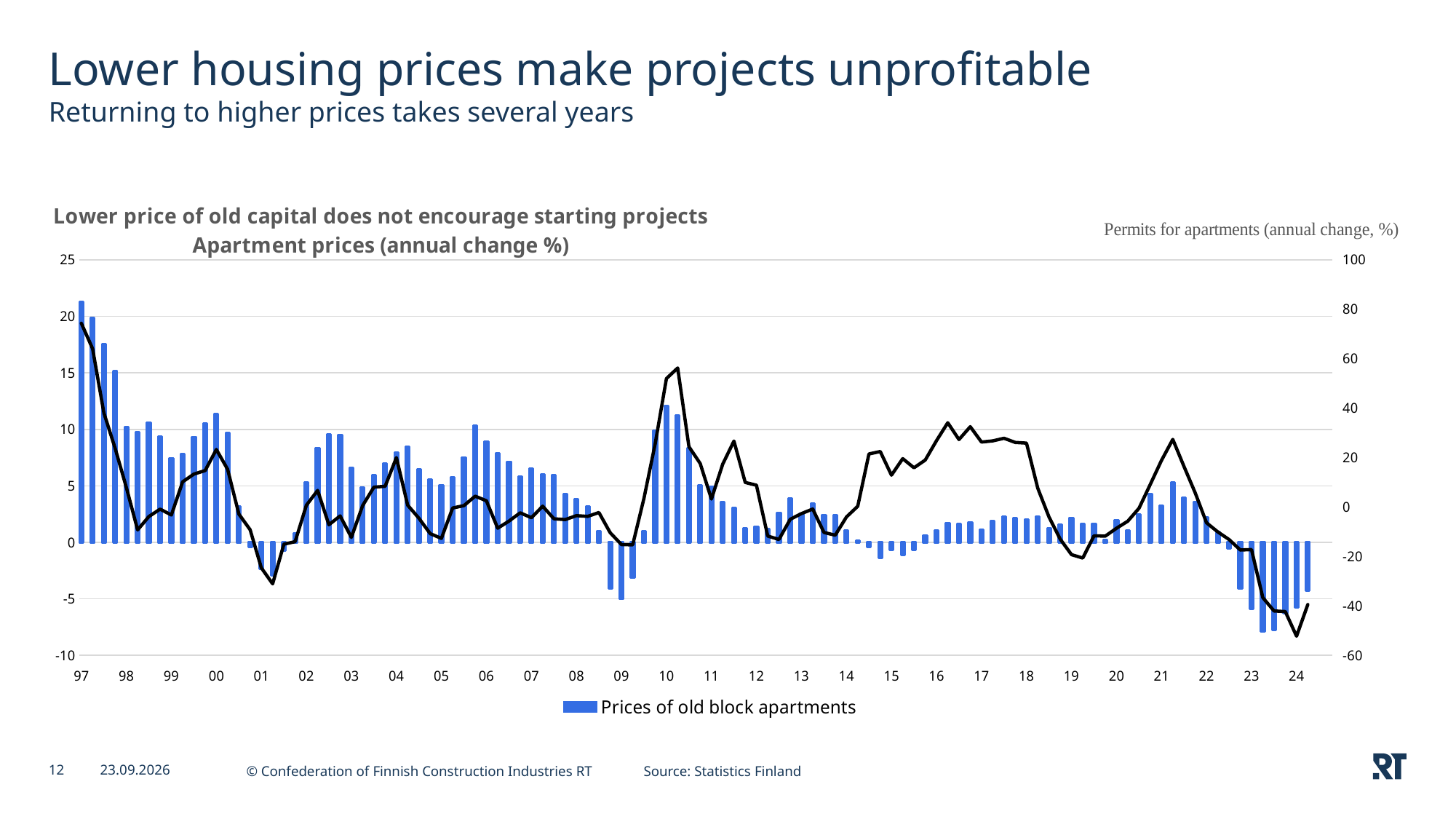
In which year does the tallest bar for prices of old block apartments occur? 97 Do the bars for prices of old block apartments rise or fall from 97 to 99? fall Is the lowest point of the permits line in 24 greater or less than -40 on the right axis? less How many year labels are shown on the x axis? 28 What series does the legend entry name? Prices of old block apartments Is the first bar in 97 for prices of old block apartments greater or less than 20 on the left axis? greater What does the right-hand axis of the chart measure? Permits for apartments (annual change, %) Is the lowest bar in 23 for prices of old block apartments greater or less than -5 on the left axis? less How many series does the legend list? 1 In which year does the lowest (most negative) bar for prices of old block apartments occur? 23 What kind of chart is shown on the slide? A bar chart combined with a line chart